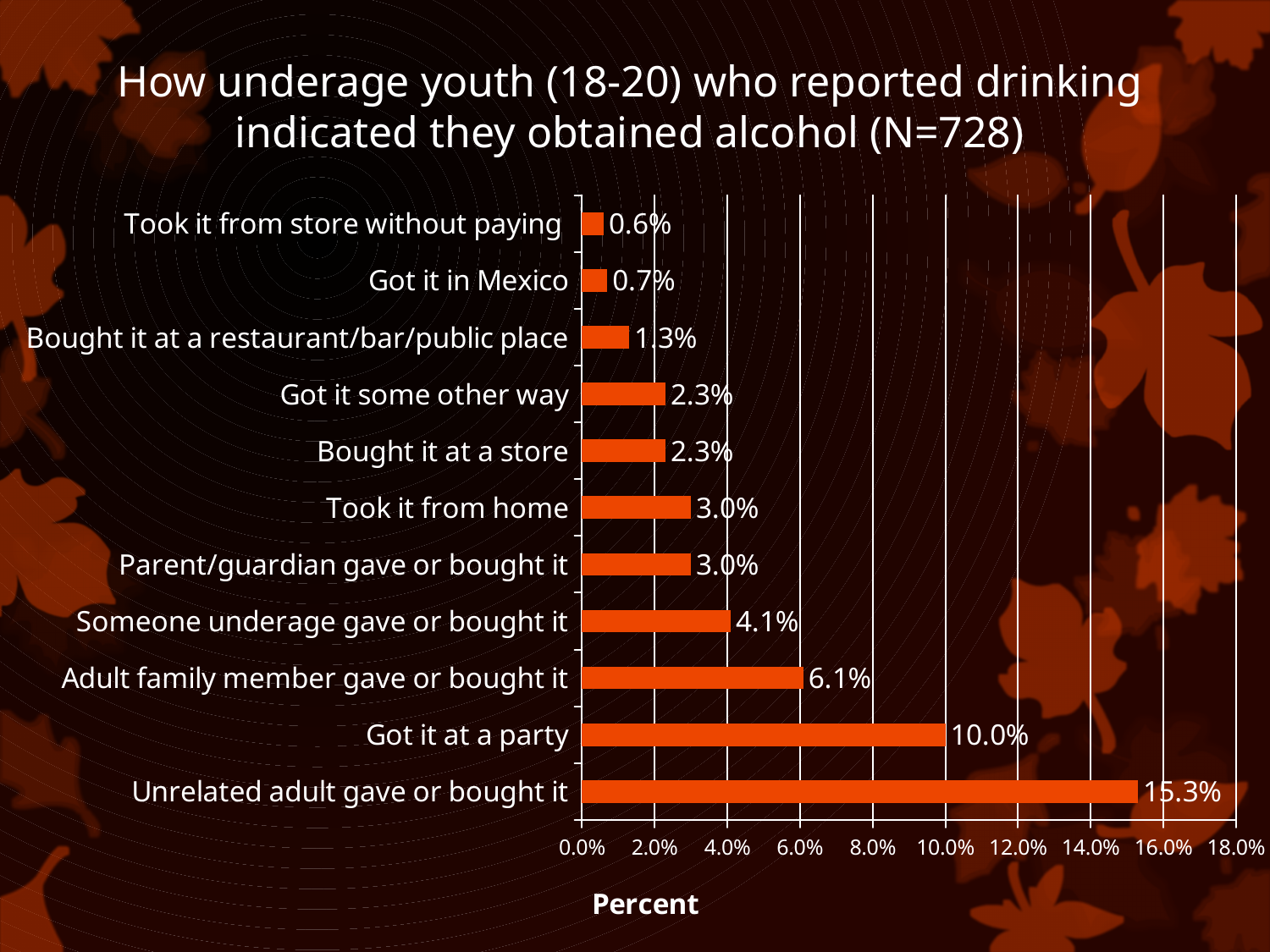
How many ways of obtaining alcohol are shown in the chart? 11 What percentage of underage youth reported they got alcohol at a party? 10.0% Which way of obtaining alcohol has the highest percentage? Unrelated adult gave or bought it Which way of obtaining alcohol has the lowest percentage? Took it from store without paying What percentage of underage youth reported an unrelated adult gave or bought alcohol for them? 15.3% What kind of chart is shown on the slide? Bar chart What percentage of underage youth reported they got alcohol in Mexico? 0.7% What is the label of the horizontal axis? Percent Which is larger: the percentage for 'Adult family member gave or bought it' or 'Someone underage gave or bought it'? Adult family member gave or bought it What is the difference in percentage points between 'Unrelated adult gave or bought it' and 'Got it at a party'? 5.3% Is the value for 'Got it at a party' greater or less than 8.0%? greater What is the sample size (N) stated in the chart title? 728